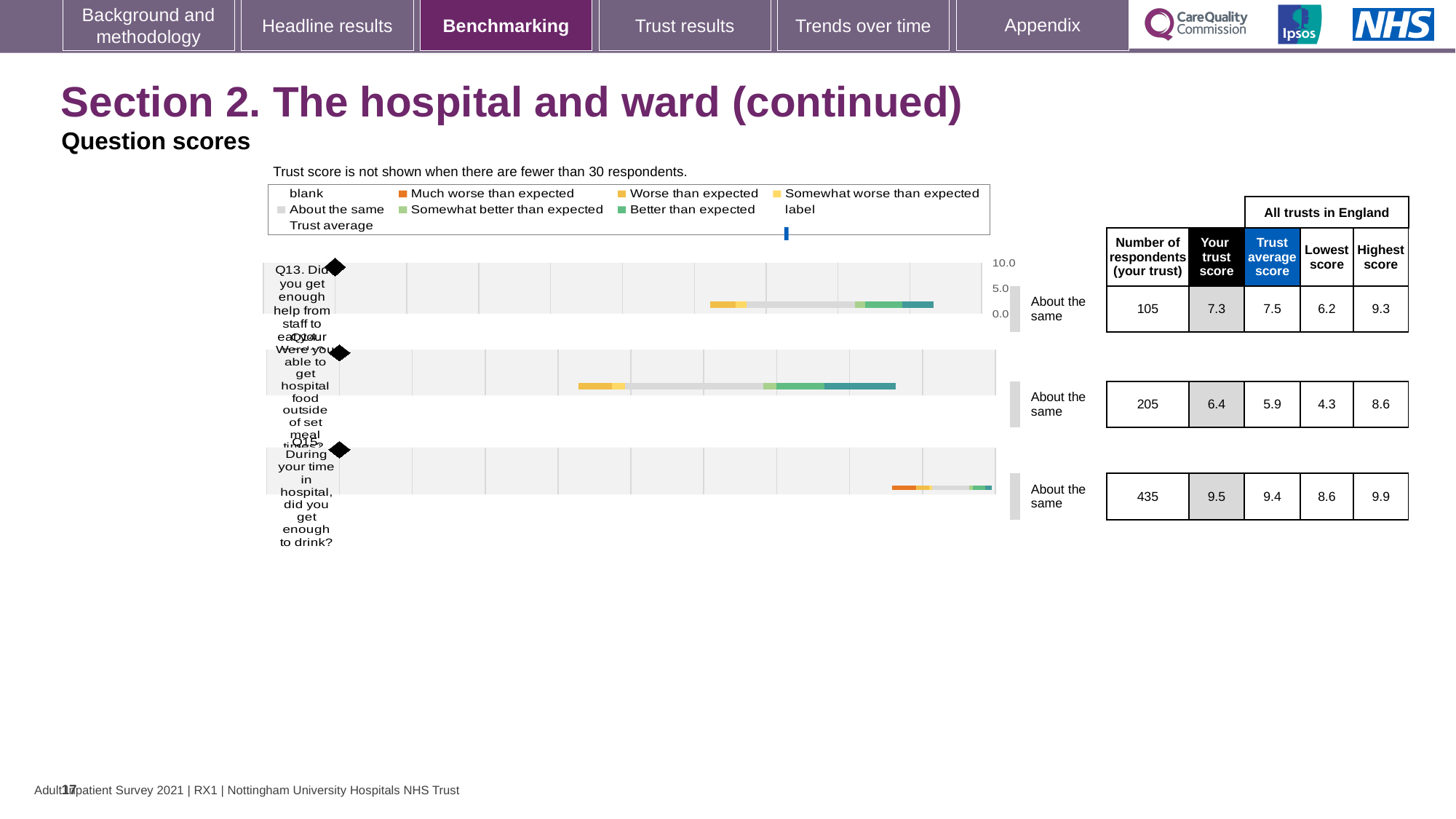
What kind of chart is used to show the question scores on this slide? bar chart How many respondents answered Q14 (Were you able to get hospital food outside of set meal times?)? 205 What is the highest score across all trusts in England for Q15 (did you get enough to drink?)? 9.9 What benchmark category is shown next to the Q13 chart? About the same What is the difference between the highest score and the lowest score for Q15? 1.3 For Q13, which is larger: the trust score or the trust average score? Trust average score What is the trust score for Q13 (Did you get enough help from staff to eat your meals?)? 7.3 Which question has the highest trust score? Q15 Which question has the lowest trust score? Q14 How many questions (Q13, Q14, Q15) are plotted on the slide? 3 For Q14, how much higher is the trust score than the trust average score? 0.5